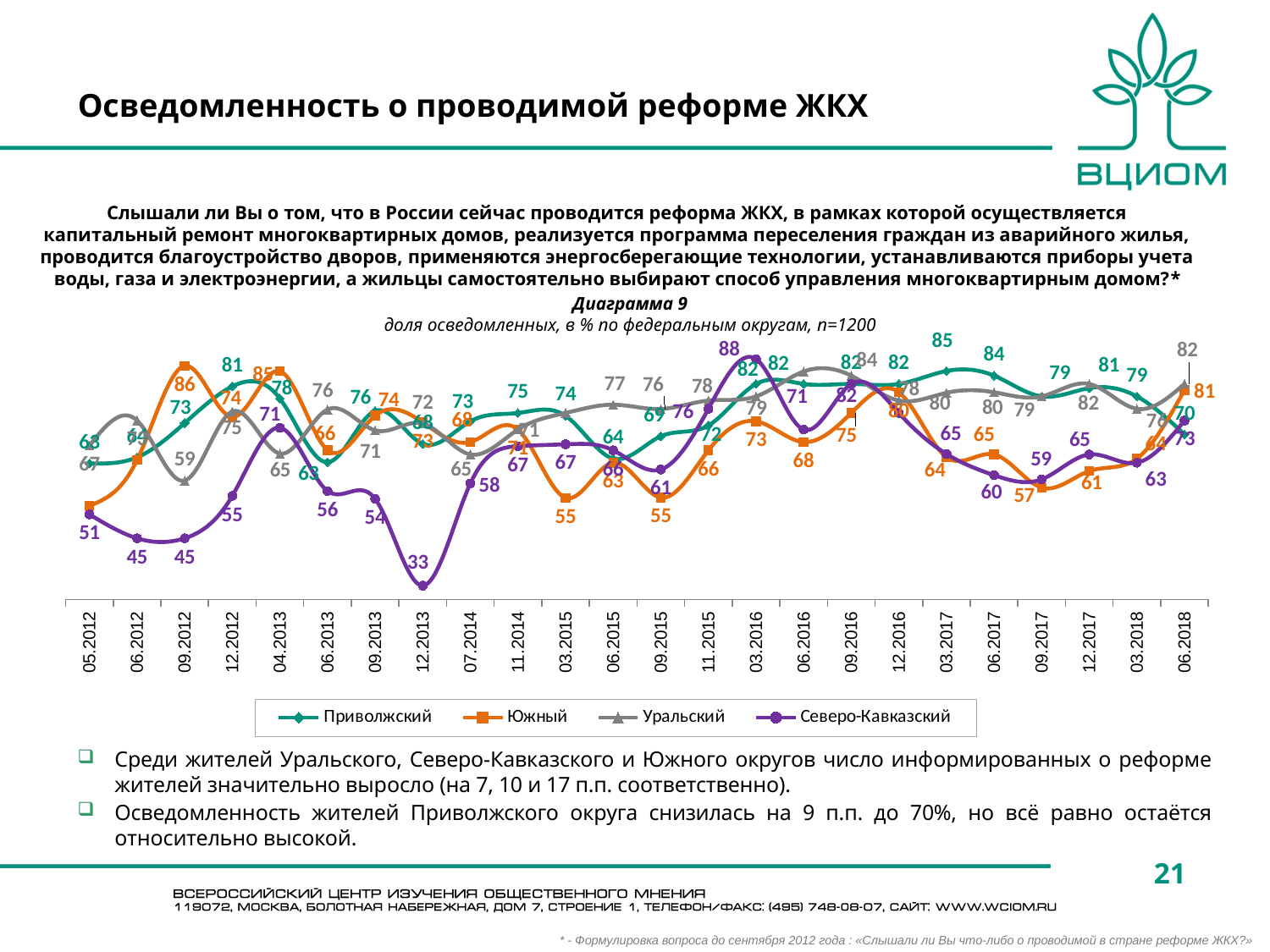
What kind of chart is shown on the slide? line chart How many time points are shown on the x axis? 24 What is the value for Южный in 09.2012? 86 How many series does the legend list? 4 In which period does the Северо-Кавказский series reach its lowest value? 12.2013 Which is larger in 12.2013: the value for Южный or for Северо-Кавказский? Южный What is the value for Южный in 06.2018? 81 What is the difference between the Южный and Приволжский values in 06.2018? 11 What is the value for Приволжский in 06.2018? 70 In which period does the Северо-Кавказский series reach its highest value? 03.2016 What is the value for Северо-Кавказский in 12.2013? 33 What is the value for Северо-Кавказский in 06.2018? 73